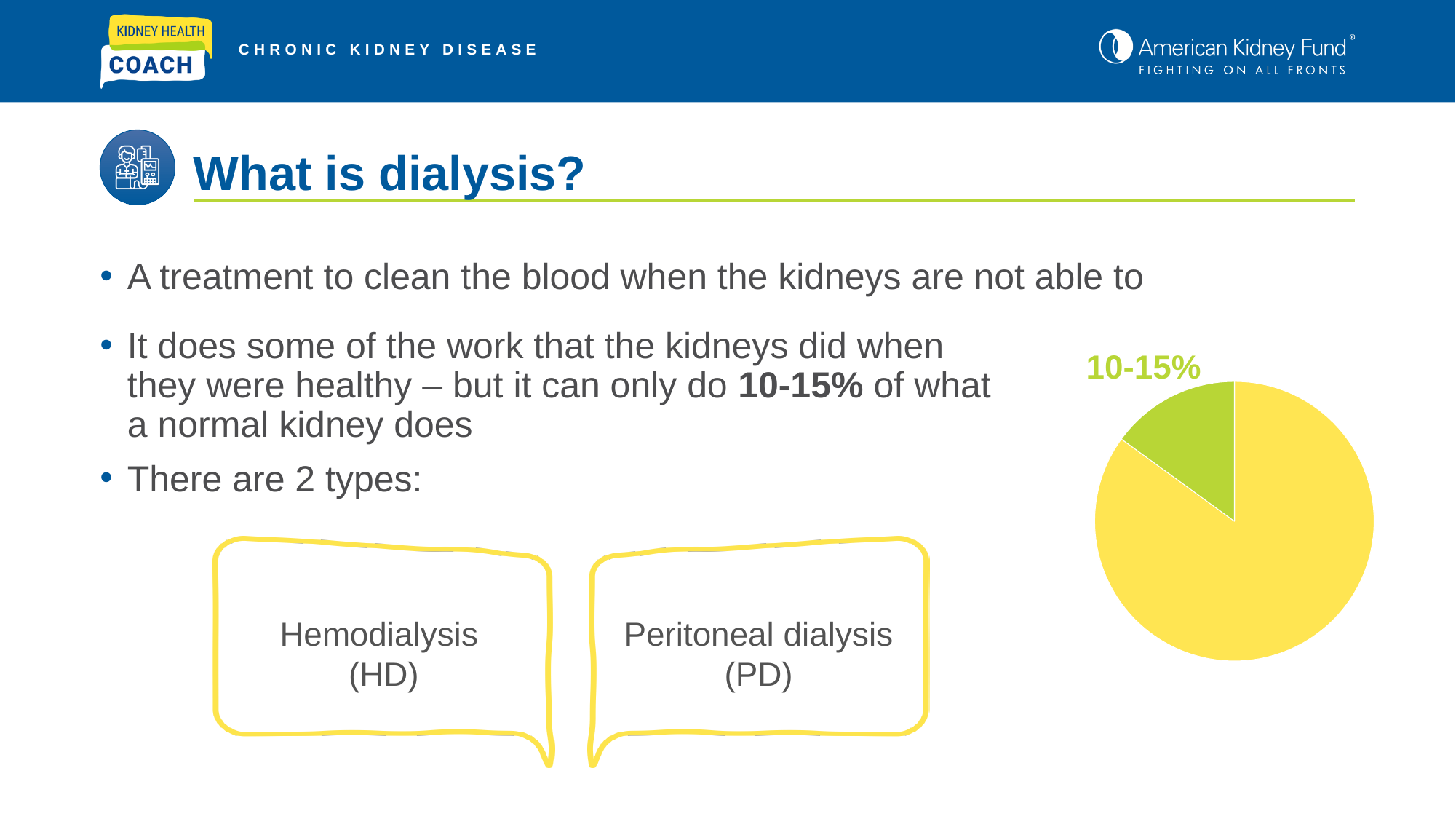
Does the pie chart have a legend? No Does the green slice of the pie chart represent more or less than half of the pie? less What label is printed next to the green slice of the pie chart? 10-15% How many slices does the pie chart have? 2 Which colour slice is the smallest in the pie chart? green What colour is the slice of the pie chart labelled 10-15%? green Which colour slice is the largest in the pie chart? yellow Which slice of the pie chart is larger, the yellow one or the green one? yellow What kind of chart is shown on the right side of the slide? pie chart What share of the pie does the green slice represent, according to its label? 10-15%